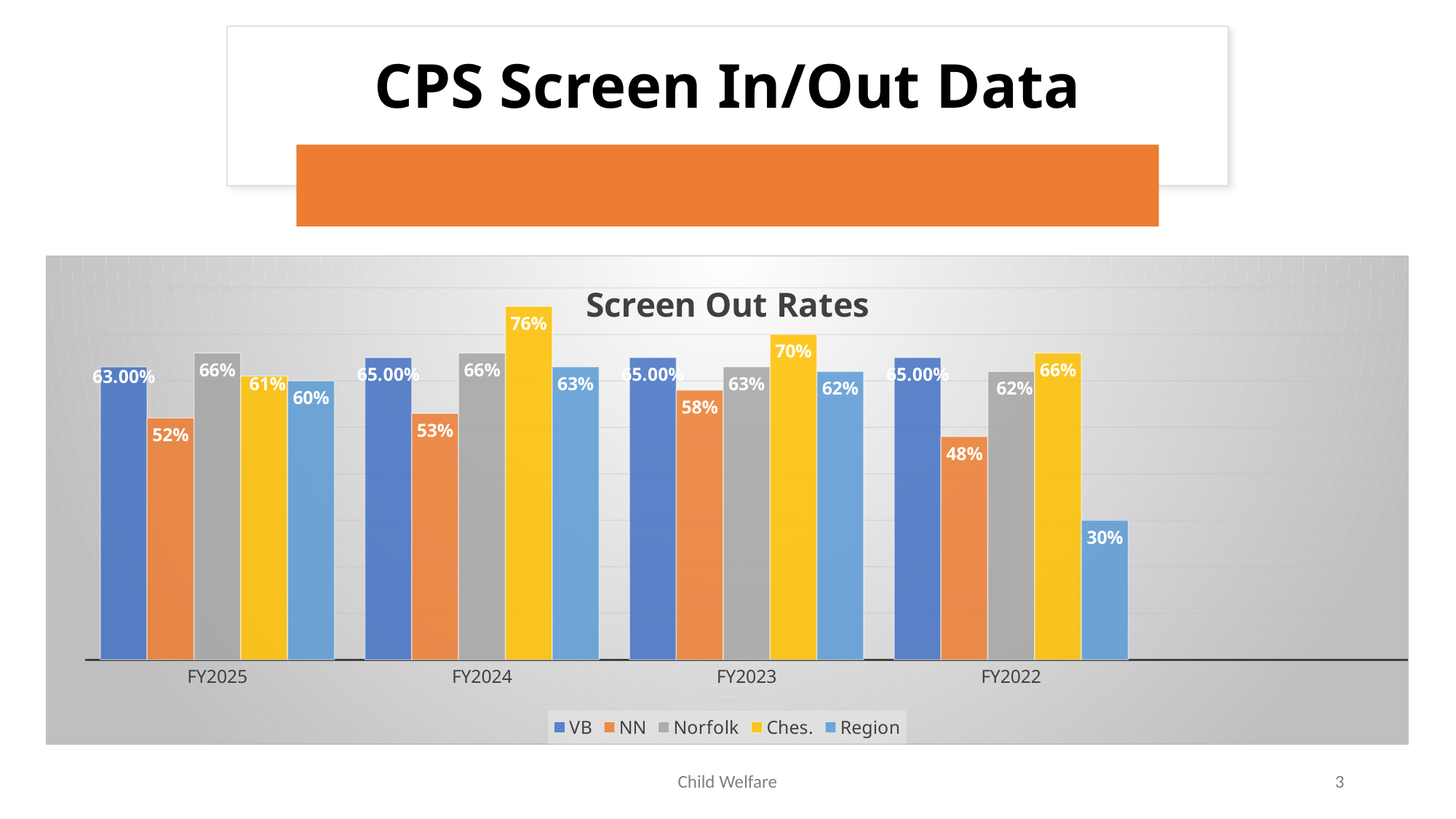
Which is larger in FY2025: the Norfolk rate or the Ches. rate? Norfolk What is the screen out rate for Region in FY2022? 30% How many fiscal years are shown on the x axis? 4 Which series has the lowest screen out rate in FY2022? Region What is the screen out rate for Ches. in FY2024? 76% What is the title of the chart? Screen Out Rates What kind of chart is shown on the slide? Bar chart What is the screen out rate for NN in FY2022? 48% Which series has the highest screen out rate in FY2023? Ches. How many series does the legend list? 5 What is the screen out rate for VB in FY2025? 63.00% What is the difference between the Ches. and NN screen out rates in FY2024? 23%